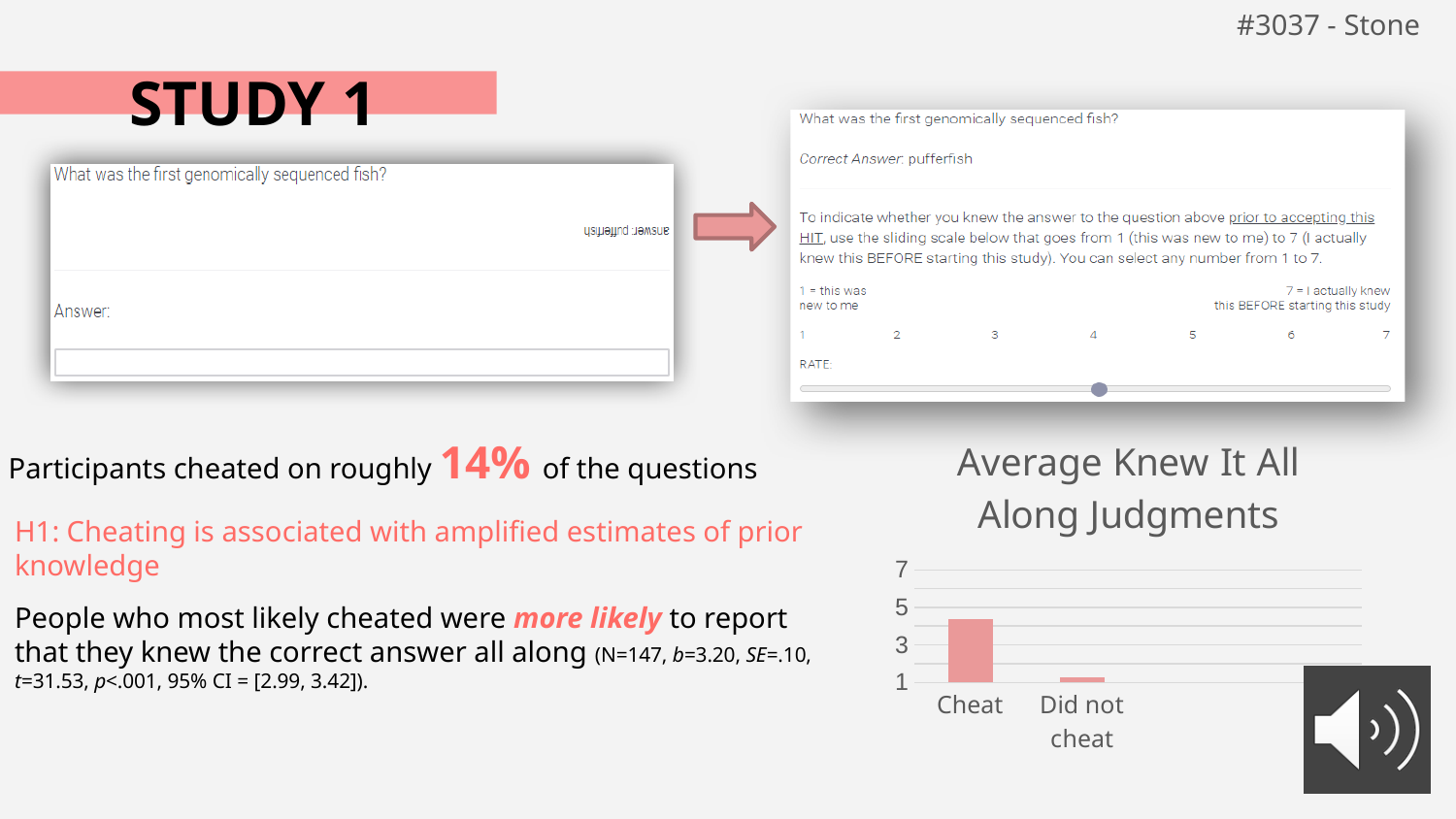
In the "Average Knew It All Along Judgments" chart, is the value for Did not cheat greater or less than 3? less What kind of chart is shown under the title "Average Knew It All Along Judgments"? bar chart What is the title of the chart on the slide? Average Knew It All Along Judgments Which category has the lowest value in the "Average Knew It All Along Judgments" chart? Did not cheat In the "Average Knew It All Along Judgments" chart, is the value for Cheat greater or less than 5? less What is the highest tick value shown on the y axis of the "Average Knew It All Along Judgments" chart? 7 In the "Average Knew It All Along Judgments" chart, is the value for Cheat greater or less than 3? greater Which category has the highest value in the "Average Knew It All Along Judgments" chart? Cheat In the "Average Knew It All Along Judgments" chart, which is larger: the value for Cheat or the value for Did not cheat? Cheat How many categories are plotted in the "Average Knew It All Along Judgments" chart? 2